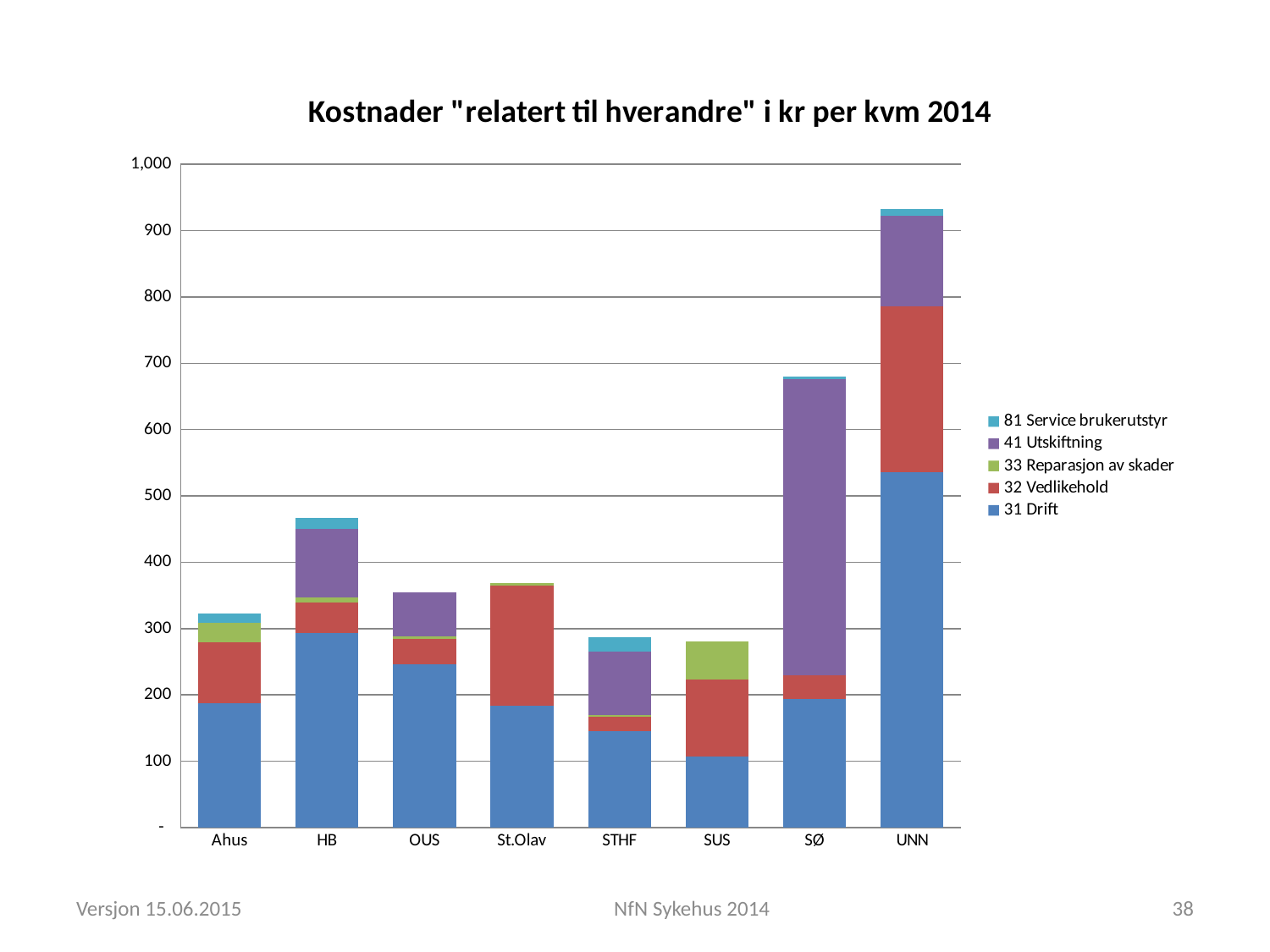
Which hospital has the highest total cost per kvm? UNN Which has the larger total bar, HB or OUS? HB What is the title of the chart? Kostnader "relatert til hverandre" i kr per kvm 2014 Is the total bar for HB greater or less than 400? greater Is the total bar for St.Olav greater or less than 400? less Which has the larger total bar, Ahus or St.Olav? St.Olav How many series does the legend list? 5 Is the total bar for UNN greater or less than 900? greater How many hospitals (categories) are shown on the x axis? 8 Which hospital has the smallest 31 Drift segment? SUS Which hospital has the largest 41 Utskiftning segment? SØ What kind of chart is shown on the slide? Stacked bar chart